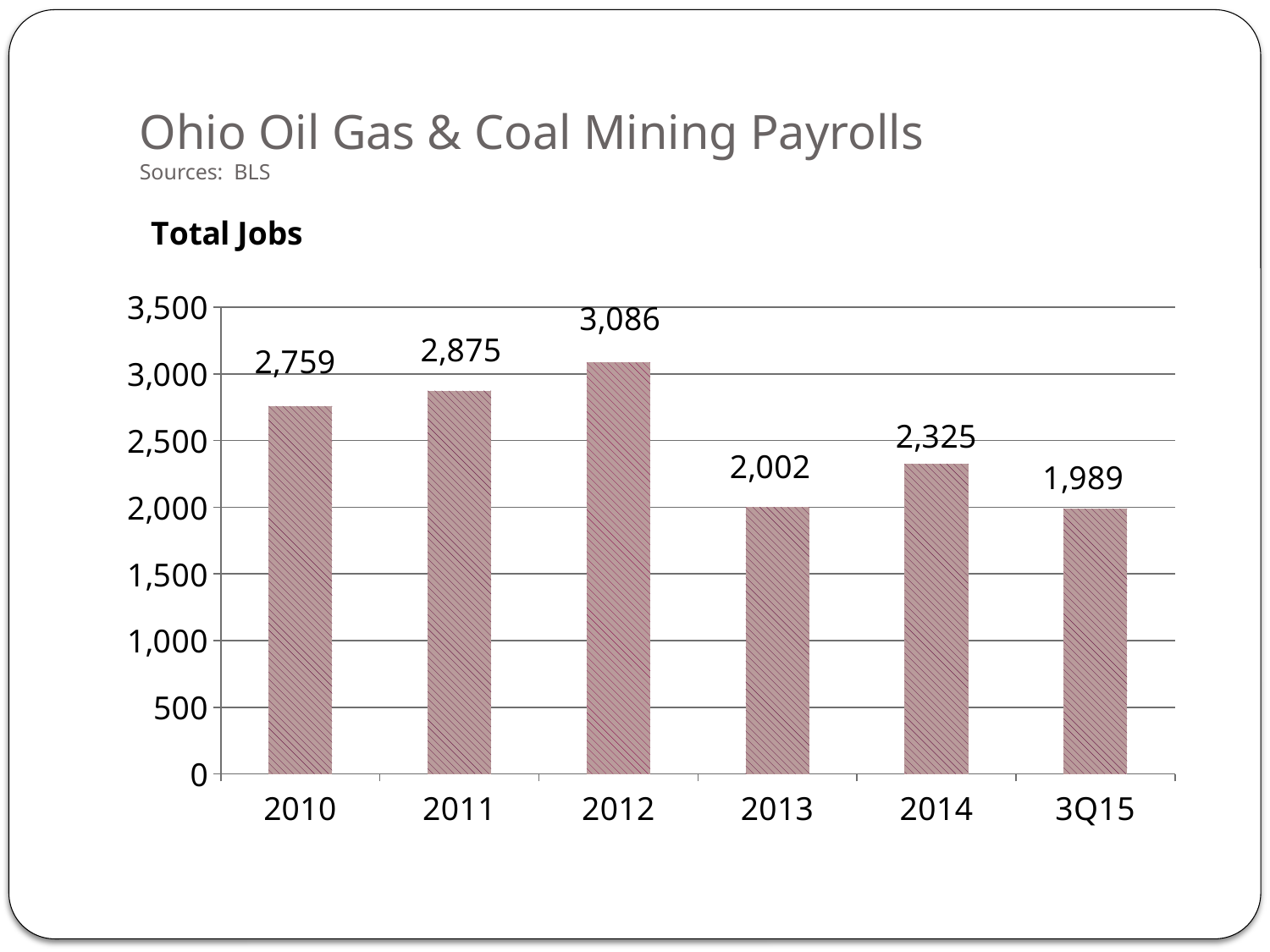
What is the value for 2010? 2,759 Which is larger, the value for 2014 or the value for 2013? 2014 What kind of chart is shown on the slide? bar chart What is the title of the chart? Total Jobs What is the difference between the values for 2012 and 2013? 1,084 Which category has the highest value? 2012 How many categories are shown on the x axis? 6 What is the value for 3Q15? 1,989 What is the difference between the values for 2011 and 2010? 116 What is the value for 2012? 3,086 Is the value for 2011 greater or less than 2,500? greater Which category has the lowest value? 3Q15